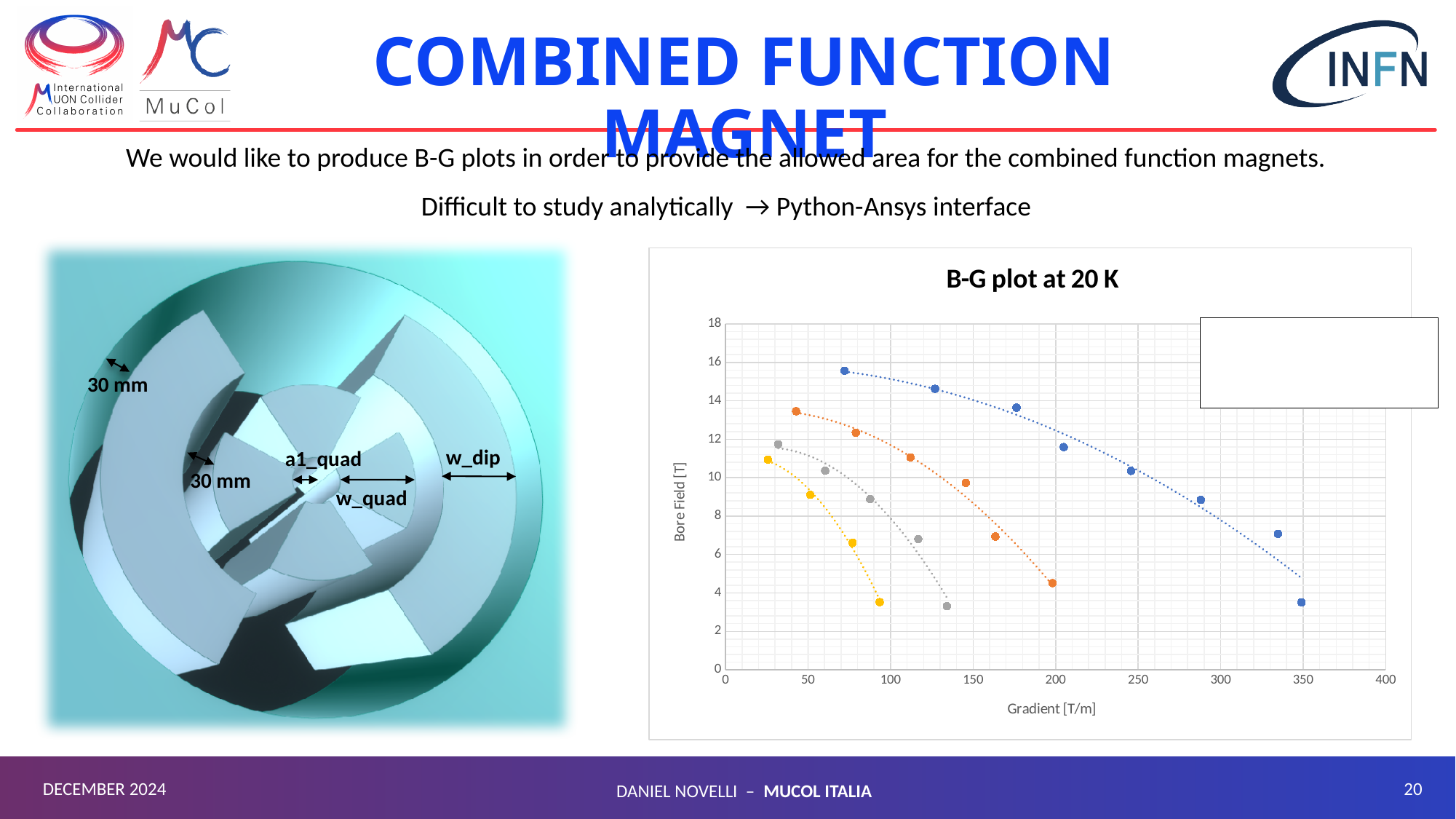
In the B-G plot, which coloured series reaches the highest bore field? blue In the B-G plot, is the highest bore field of the blue series greater or less than 14 T? greater What kind of chart is the "B-G plot at 20 K"? scatter plot In the B-G plot, which series reaches a higher bore field at its first point: the orange series or the gray series? orange What is the title of the chart on the slide? B-G plot at 20 K In the B-G plot, is the highest bore field of the yellow series greater or less than 12 T? less In the B-G plot, is the largest gradient reached by the orange series greater or less than 150 T/m? greater How many points are plotted for the yellow series in the B-G plot? 4 In the B-G plot, does the bore field rise or fall as the gradient increases along the x axis? fall In the B-G plot, which coloured series stays at the lowest gradient values? yellow In the B-G plot, which coloured series extends to the highest gradient values? blue What is the label of the y axis of the B-G plot? Bore Field [T]